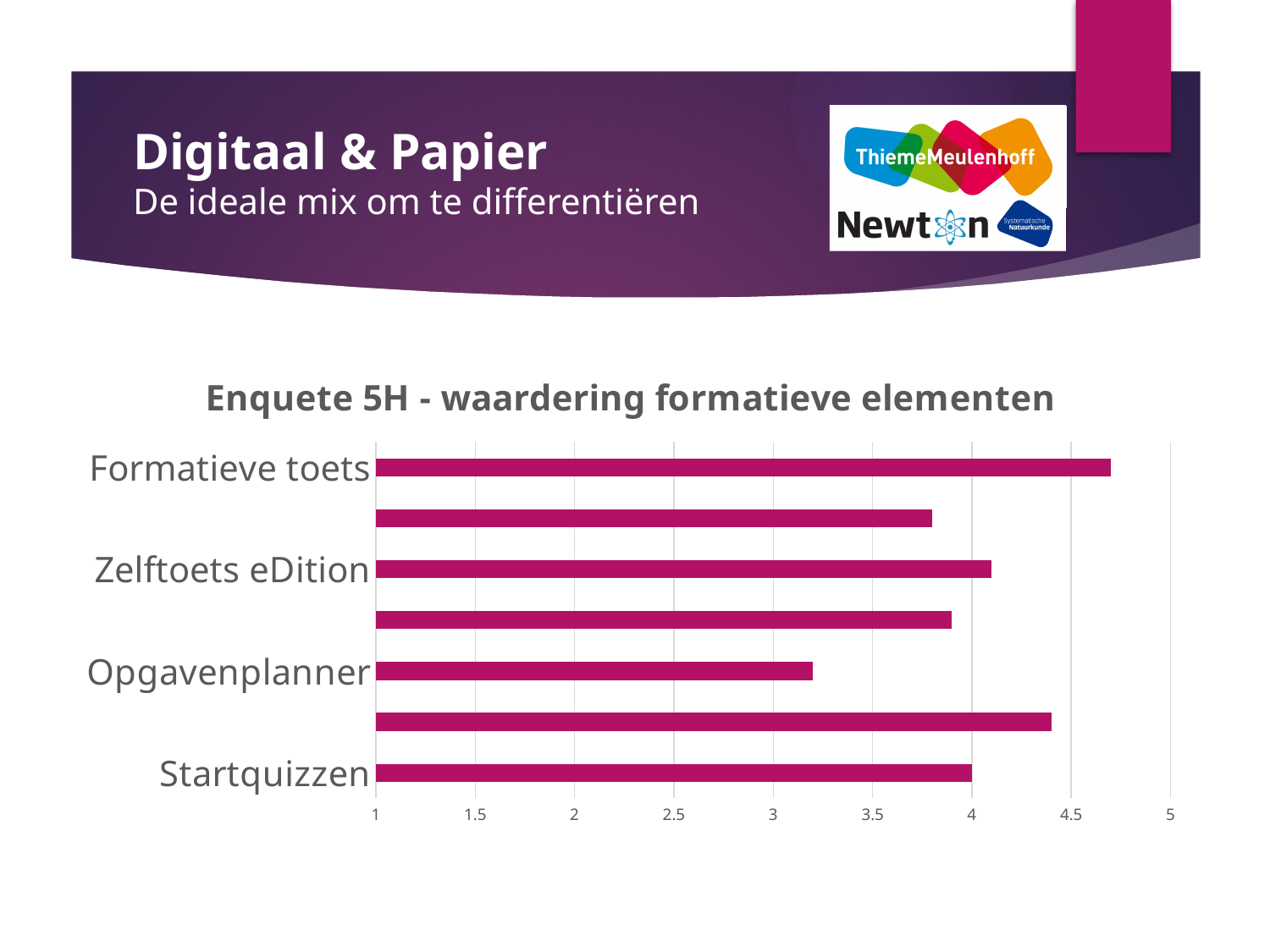
What is the title of the chart? Enquete 5H - waardering formatieve elementen How many bars are plotted in the chart? 7 Which has a higher value: Opgavenplanner or Startquizzen? Startquizzen Is the value for Opgavenplanner greater or less than 3.5? less What colour are the bars in the chart? Magenta Is the value for Formatieve toets greater or less than 4.5? greater Is the value for Zelftoets eDition greater or less than 3.5? greater Which labelled category has the highest value in the chart? Formatieve toets Which has a higher value: Formatieve toets or Zelftoets eDition? Formatieve toets What kind of chart is shown on the slide? Bar chart Which labelled category has the lowest value in the chart? Opgavenplanner